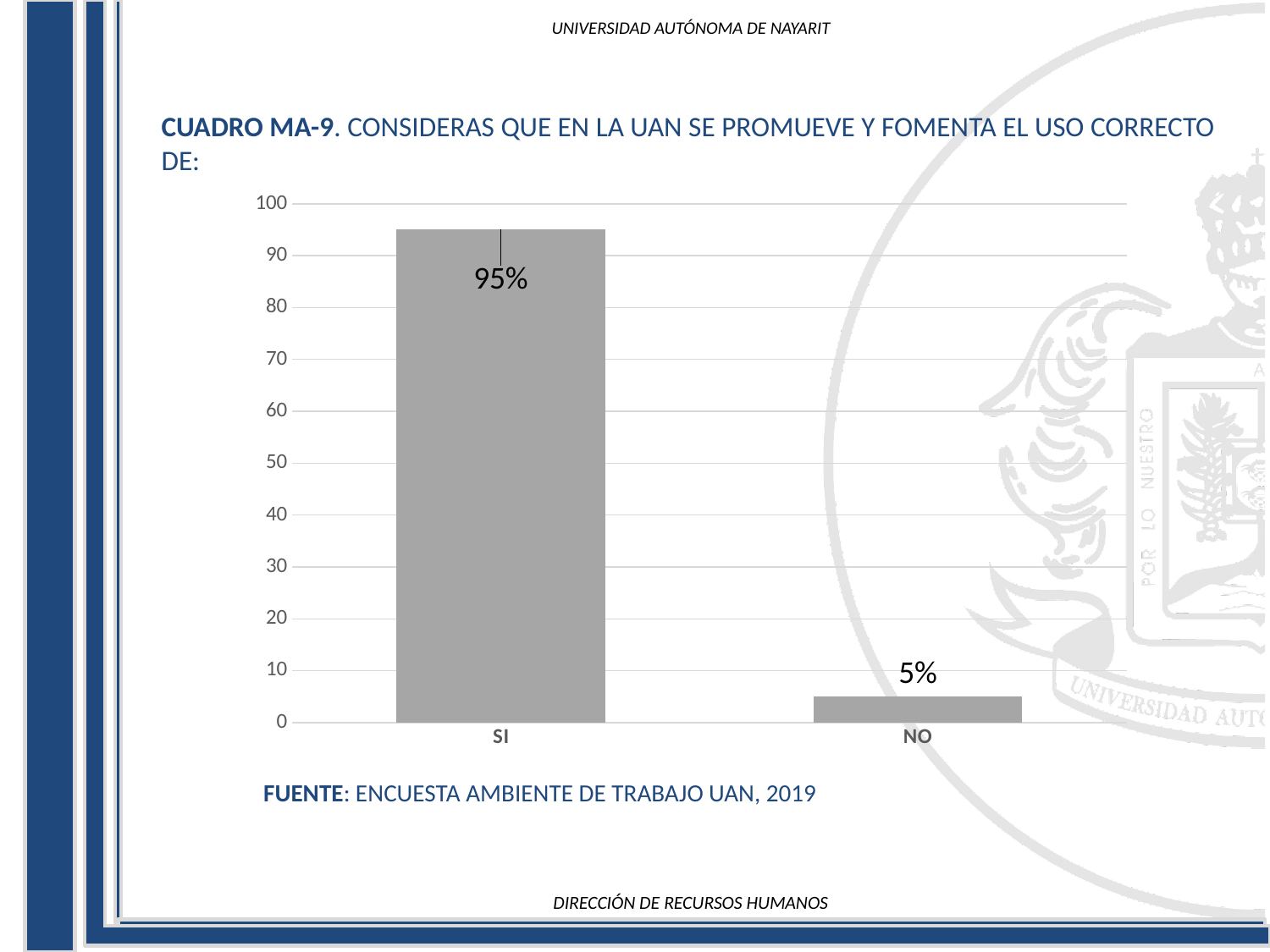
Is the value for SI greater or less than 90? greater What is the value for SI? 95% What is the maximum value shown on the y axis? 100 How many categories are shown on the x axis? 2 What source is cited below the chart? ENCUESTA AMBIENTE DE TRABAJO UAN, 2019 Which category has the lowest value? NO What is the value for NO? 5% Which category has the highest value? SI What kind of chart is shown on the slide? bar chart What is the difference between the values for SI and NO? 90% Is the value for NO greater or less than 10? less Which is larger, the value for SI or the value for NO? SI